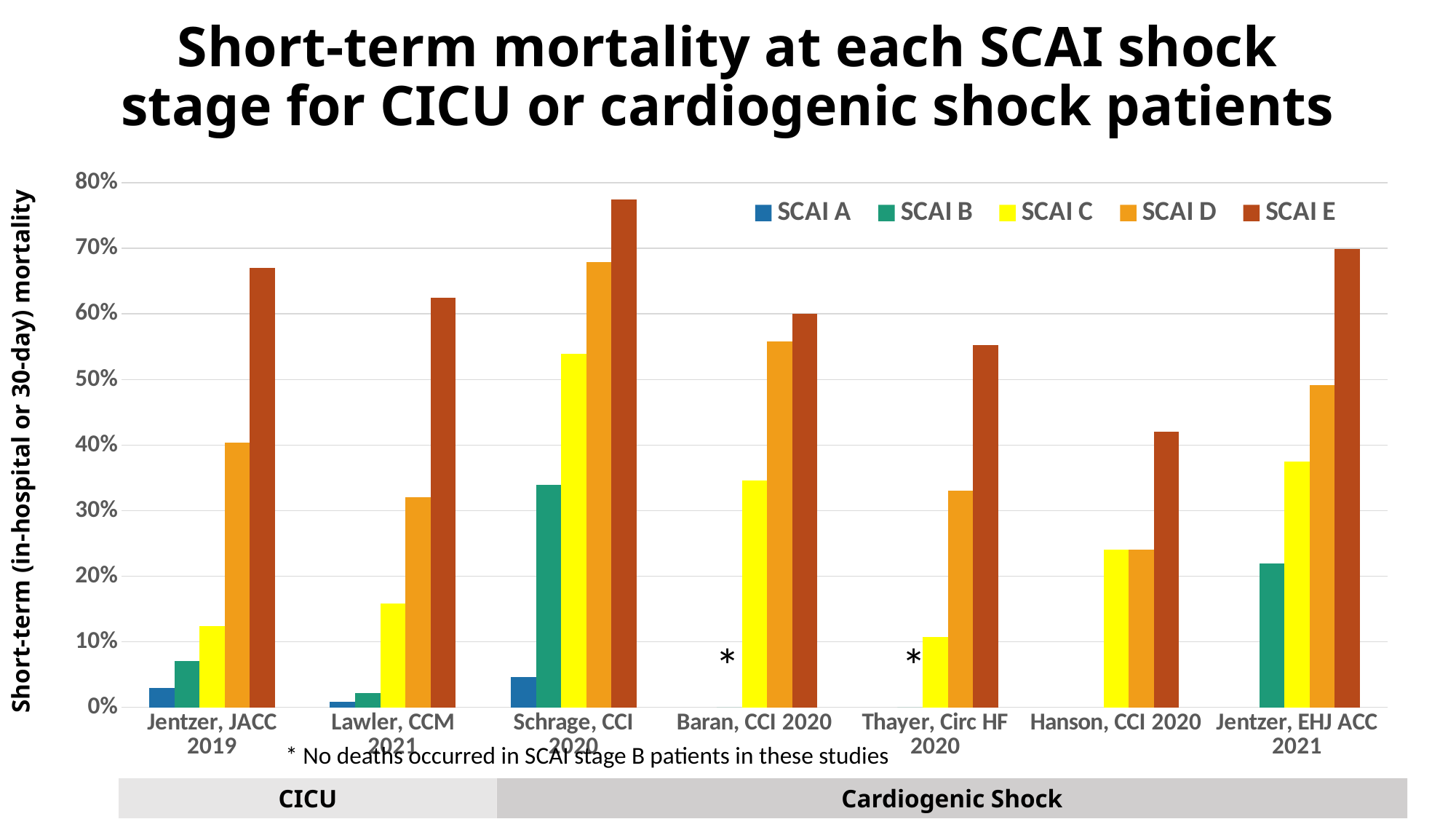
Which is larger: the SCAI D value for Lawler, CCM 2021 or the SCAI D value for Jentzer, EHJ ACC 2021? Jentzer, EHJ ACC 2021 What is the label of the y axis? Short-term (in-hospital or 30-day) mortality How many series does the legend list? 5 What kind of chart is shown on the slide? Bar chart Which is larger: the SCAI E value for Schrage, CCI 2020 or the SCAI E value for Baran, CCI 2020? Schrage, CCI 2020 How many studies (categories) are shown along the x axis? 7 Is the SCAI D value for Baran, CCI 2020 greater or less than 50%? greater Which study has the highest SCAI E mortality? Schrage, CCI 2020 Which study has the highest SCAI C mortality? Schrage, CCI 2020 Which study has the lowest SCAI E mortality? Hanson, CCI 2020 Is the SCAI B value for Schrage, CCI 2020 greater or less than 30%? greater Is the SCAI E value for Jentzer, JACC 2019 greater or less than 60%? greater